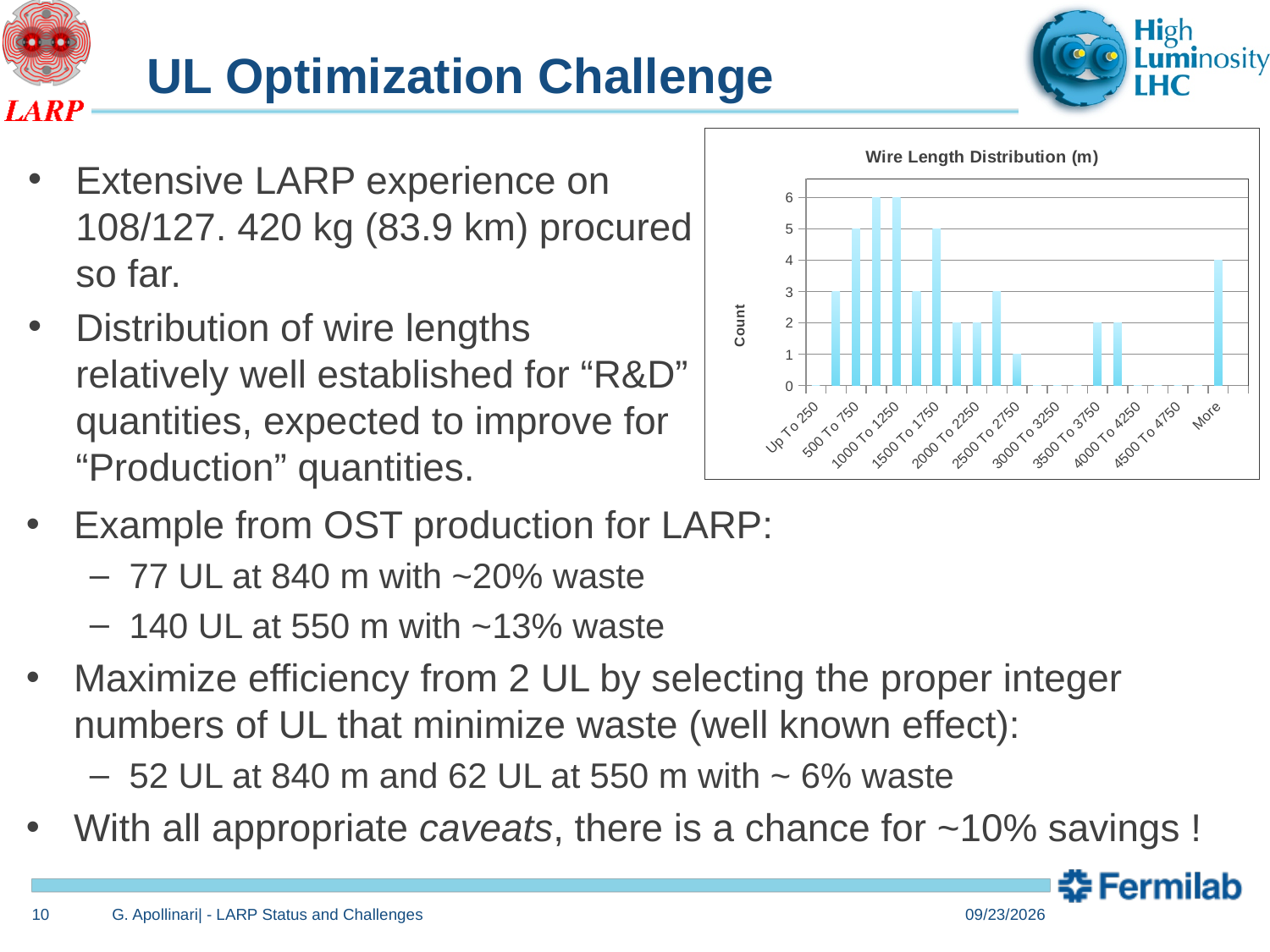
What is the label on the vertical axis of the chart? Count What is the highest count value reached by any bar in the chart? 6 What is the count for the '2000 To 2250' category? 2 What is the title of the chart? Wire Length Distribution (m) What is the count for the '1500 To 1750' category? 5 What is the count for the 'Up To 250' category? 0 What is the count for the '500 To 750' category? 5 Is the count for the 'More' category greater or less than 3? greater What is the count for the 'More' category? 4 What is the difference between the counts for '500 To 750' and 'Up To 250'? 5 What type of chart is shown on the slide? bar chart Which has a higher count, '500 To 750' or 'More'? 500 To 750